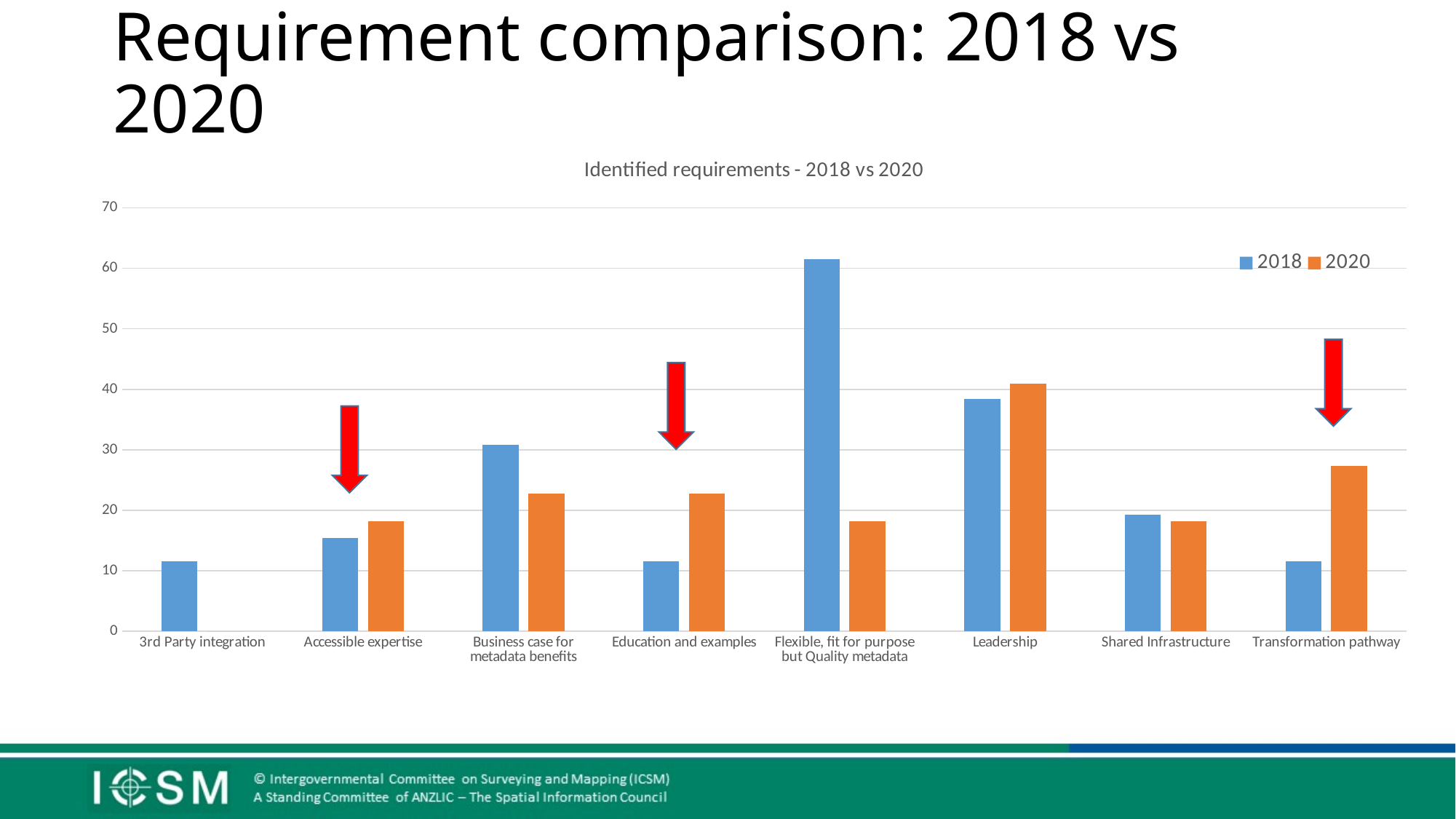
Which category has the highest 2018 value? Flexible, fit for purpose but Quality metadata How many series does the chart's legend list? 2 Which colour represents the 2020 series in the chart? Orange Which category has the highest 2020 value? Leadership For Flexible, fit for purpose but Quality metadata, which is larger: the 2018 value or the 2020 value? 2018 Is the 2018 value for Flexible, fit for purpose but Quality metadata greater or less than 50? greater For Education and examples, which is larger: the 2018 value or the 2020 value? 2020 Is the 2020 value for Transformation pathway greater or less than 30? less What kind of chart is shown on the slide? Bar chart For Transformation pathway, which is larger: the 2018 value or the 2020 value? 2020 How many categories are shown on the x axis of the chart? 8 What is the title of the chart? Identified requirements - 2018 vs 2020